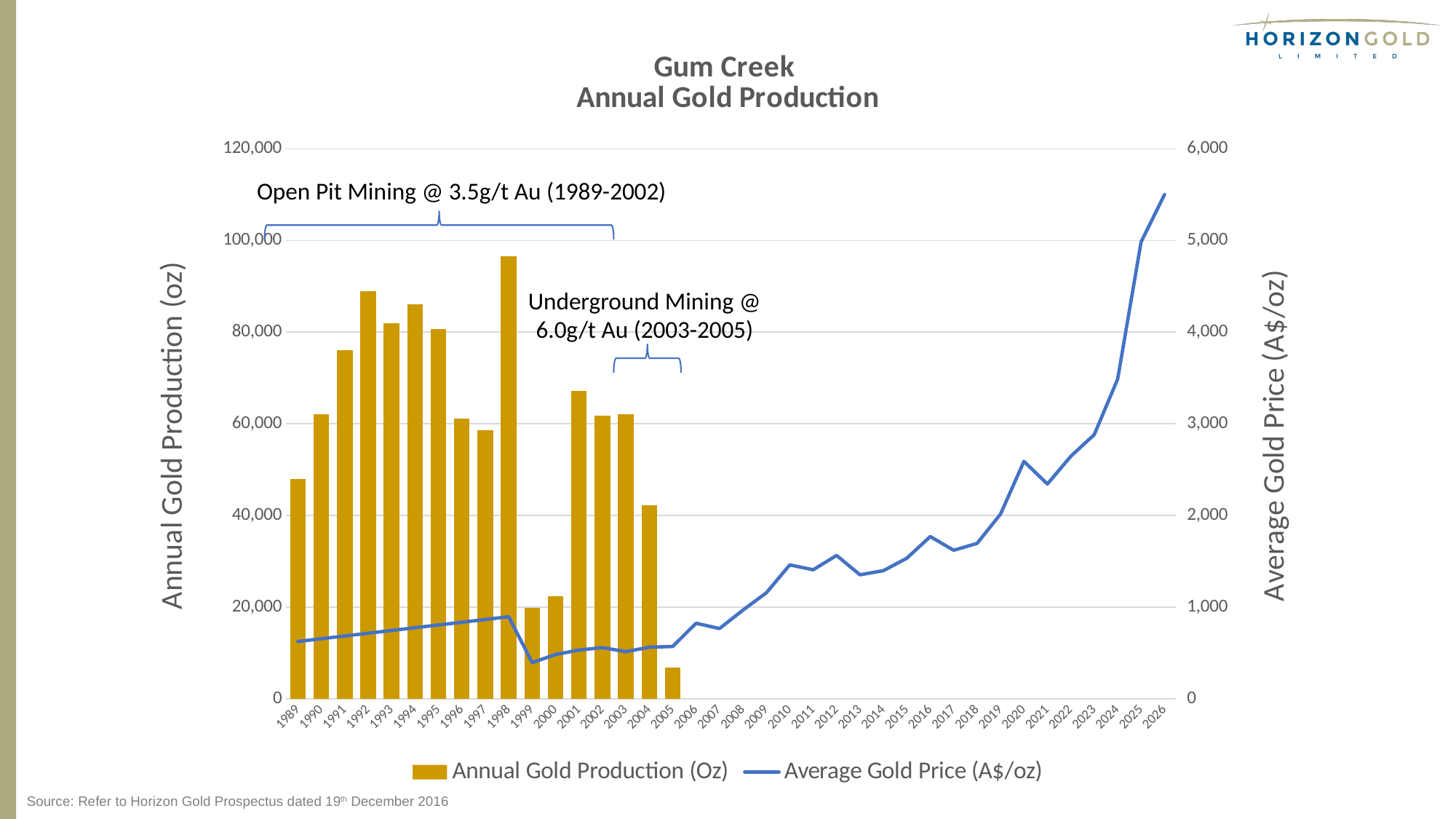
Does the Average Gold Price line generally rise or fall from 2005 to 2026? rise Which year has the lowest Annual Gold Production bar? 2005 Which year has higher Annual Gold Production, 1992 or 1993? 1992 Which year has the highest Annual Gold Production? 1998 Is the Annual Gold Production for 1998 greater or less than 80,000? greater How many series does the legend list? 2 What kind of chart is this? Combined bar and line chart What is the title of the chart? Gum Creek Annual Gold Production How many years have an Annual Gold Production bar? 17 Is the Average Gold Price for 2026 greater or less than 5,000? greater Is the Annual Gold Production for 1989 greater or less than 60,000? less